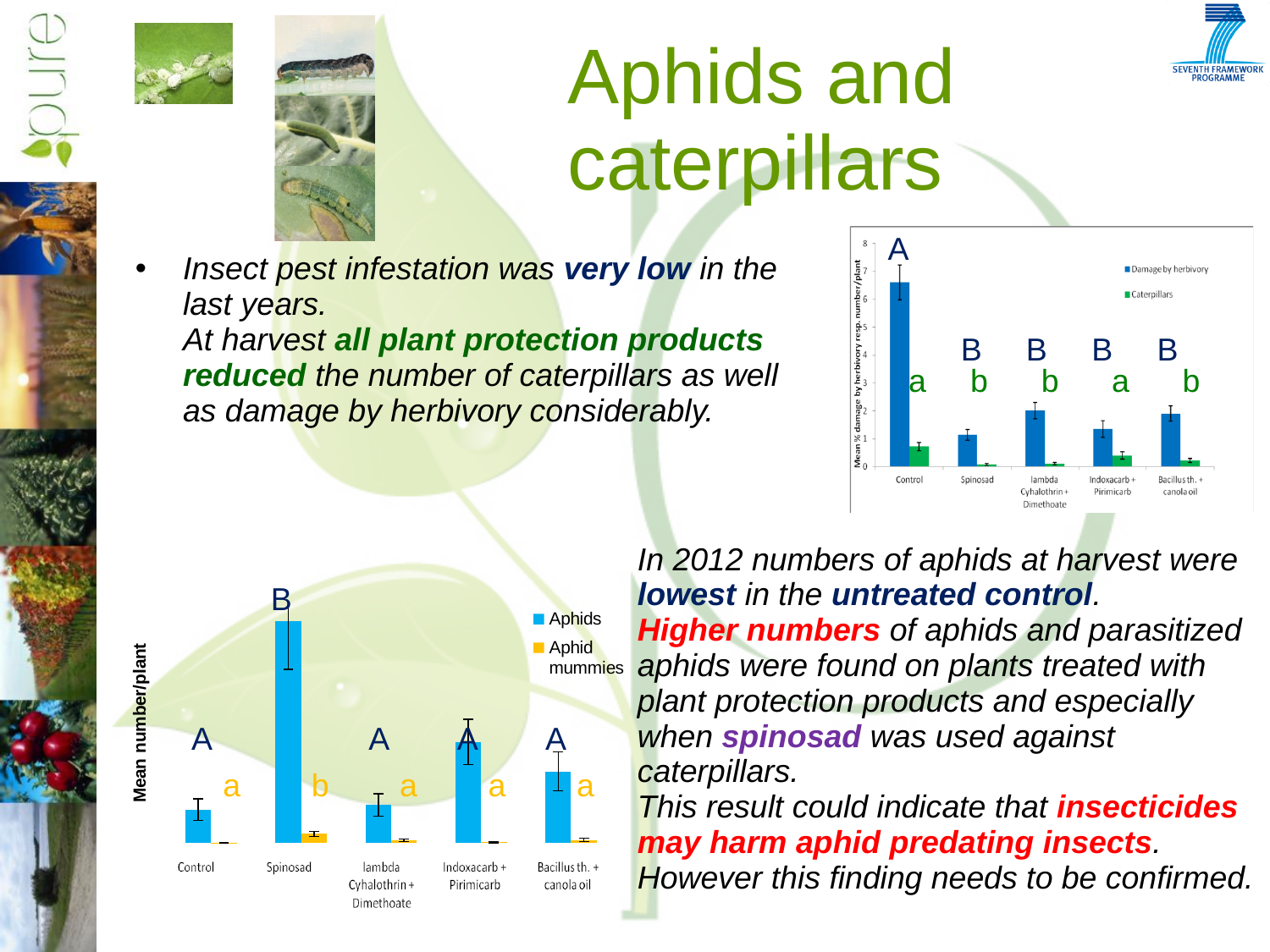
In the top-right chart, is the Caterpillars value for Control greater or less than 1? less What are the two series named in the legend of the top-right chart? Damage by herbivory, Caterpillars In the top-right chart, is the Damage by herbivory value for Spinosad greater or less than 2? less How many treatment categories are shown on the x axis of the top-right chart? 5 In the bottom-left chart, which category has the lowest value for Aphids? Control In the top-right chart, which category has the highest value for Damage by herbivory? Control What type of chart is the chart in the top right of the slide? bar chart In the bottom-left chart, which is larger: the Aphids value for Indoxacarb + Pirimicarb or for Bacillus th. + canola oil? Indoxacarb + Pirimicarb In the top-right chart, is the Damage by herbivory value for Control greater or less than 5? greater How many series does the legend of the top-right chart list? 2 In the top-right chart, which category has the highest value for Caterpillars? Control In the bottom-left chart, which category has the highest value for Aphids? Spinosad